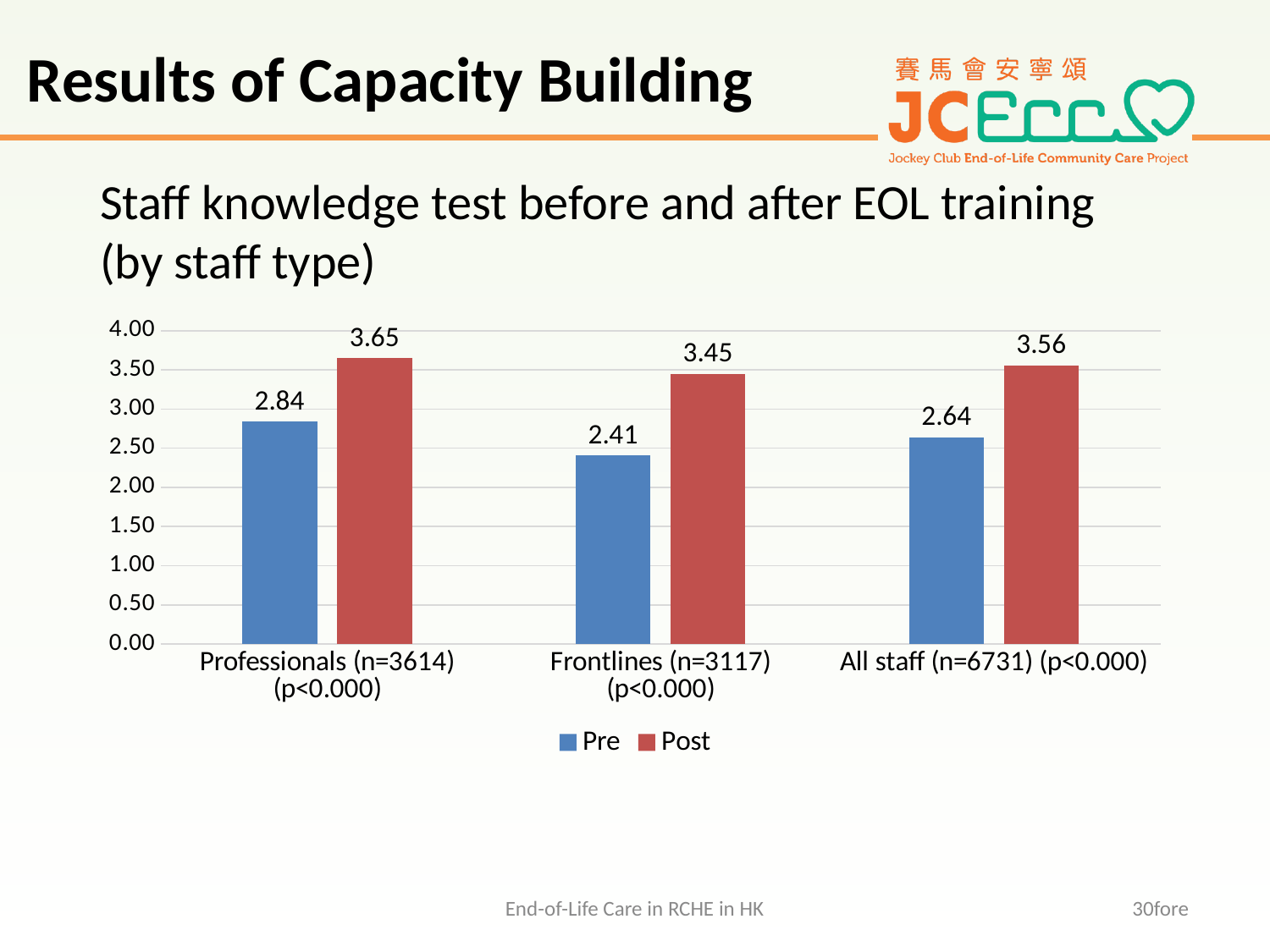
What kind of chart is shown on the slide? bar chart Which staff type has the lowest Pre value? Frontlines (n=3117) What is the Pre value for Professionals (n=3614)? 2.84 Which is larger, the Pre value for Professionals or the Pre value for All staff? Professionals What is the difference between the Post and Pre values for Professionals (n=3614)? 0.81 How many series does the legend list? 2 What is the difference between the Post and Pre values for Frontlines (n=3117)? 1.04 How many staff type categories are shown on the x axis? 3 What is the Post value for Frontlines (n=3117)? 3.45 What is the Post value for All staff (n=6731)? 3.56 Which staff type has the highest Post value? Professionals (n=3614) Is the Pre value for All staff (n=6731) greater or less than 3.00? less